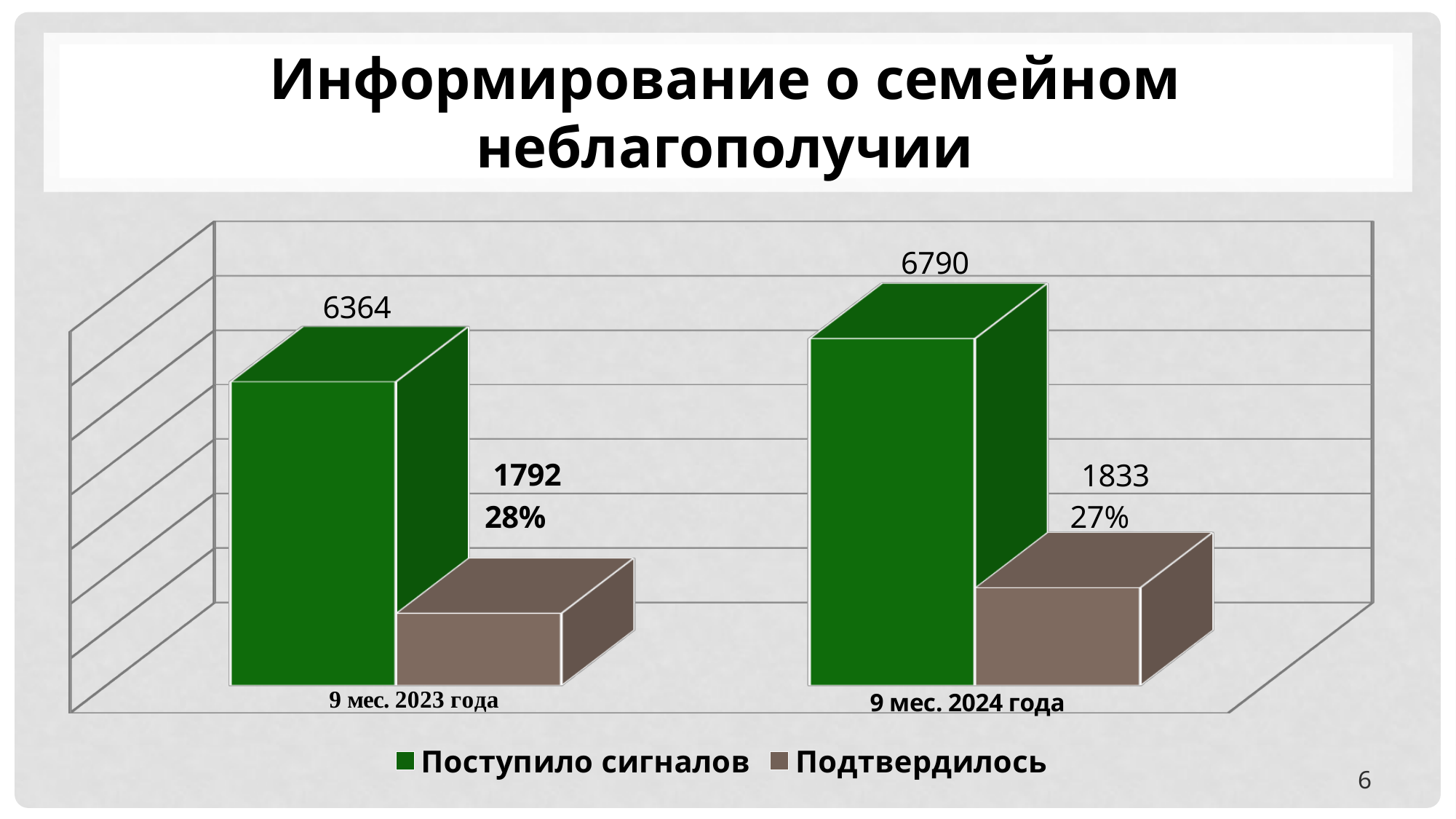
What is the difference between the "Поступило сигналов" values for 2024 and 2023? 426 What is the value of "Поступило сигналов" for "9 мес. 2023 года"? 6364 What is the value of "Поступило сигналов" for "9 мес. 2024 года"? 6790 What kind of chart is shown on the slide? Bar chart How many series does the legend list? 2 Which category has the higher value for "Поступило сигналов"? 9 мес. 2024 года What is the value of "Подтвердилось" for "9 мес. 2024 года"? 1833 What percentage is shown next to the "Подтвердилось" bar for "9 мес. 2024 года"? 27% How many categories are shown on the x axis? 2 What is the value of "Подтвердилось" for "9 мес. 2023 года"? 1792 What is the difference between the "Подтвердилось" values for 2024 and 2023? 41 Which is larger: "Поступило сигналов" for 2023 or "Подтвердилось" for 2024? Поступило сигналов for 2023